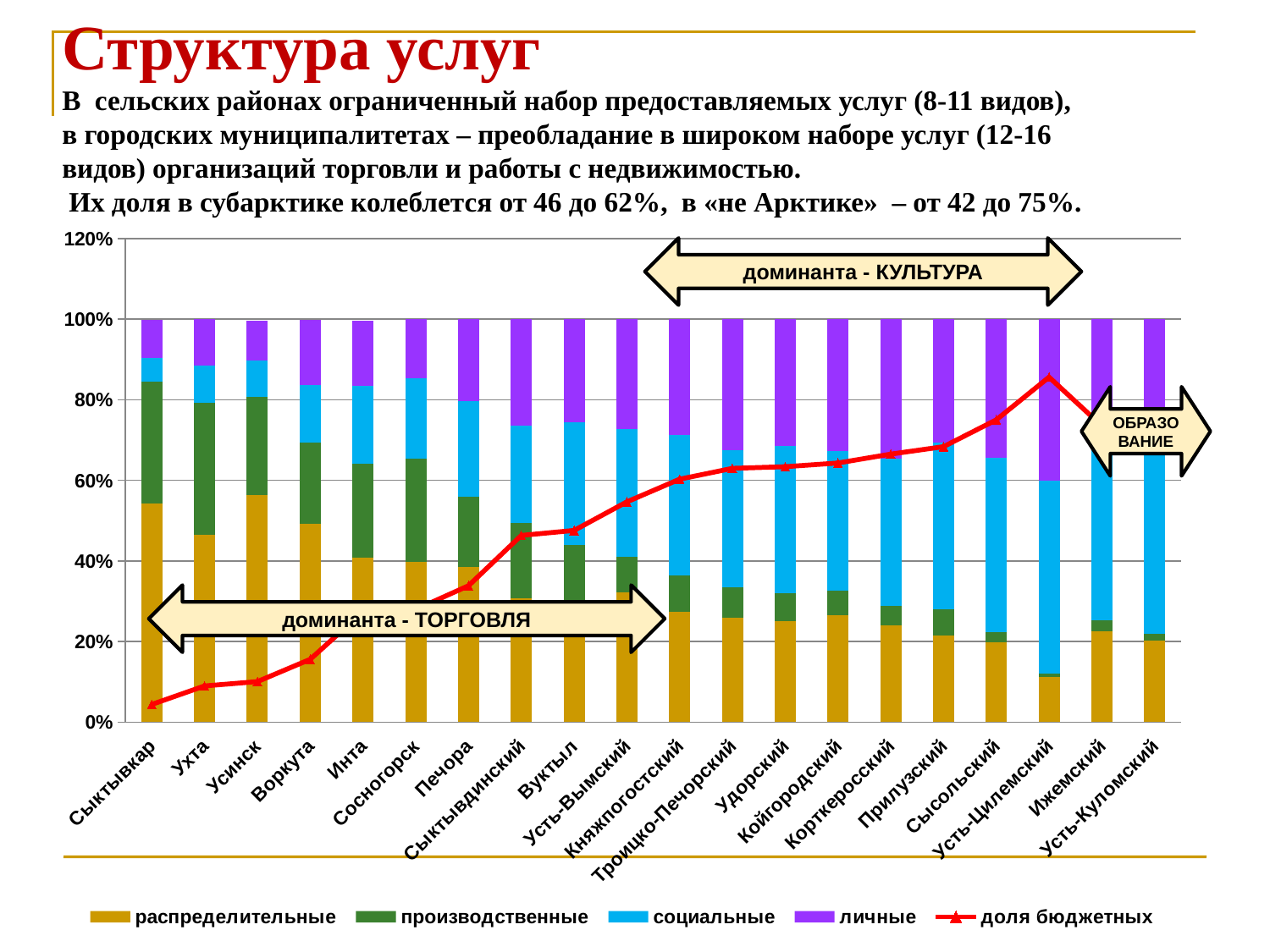
Which has a larger доля бюджетных value, Ухта or Удорский? Удорский Does the доля бюджетных line generally rise or fall from Сыктывкар to Усть-Цилемский? rise Which category has the highest value for доля бюджетных? Усть-Цилемский Is the value of доля бюджетных for Усть-Цилемский greater or less than 80%? greater Which category has the lowest value for доля бюджетных? Сыктывкар Is the распределительные segment for Сыктывкар greater or less than 40%? greater Is the распределительные segment for Усть-Цилемский greater or less than 20%? less What kind of chart is shown on the slide? combination bar and line chart (stacked bars with a line) How many categories (municipalities) are shown on the x axis? 20 How many series does the legend list? 5 What colour represents the социальные series? blue